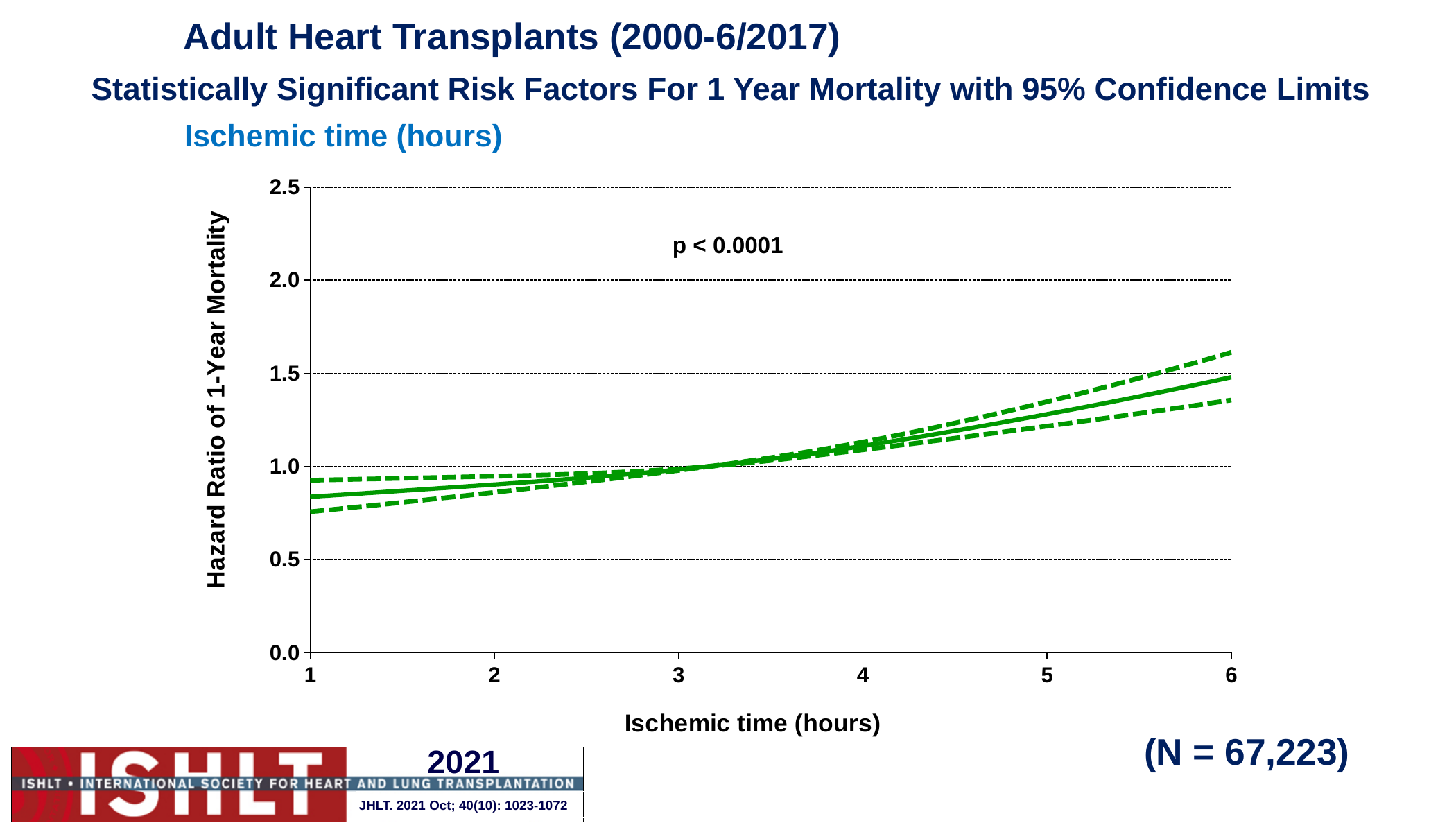
What p-value is printed on the chart? p < 0.0001 Is the hazard ratio (solid line) at an ischemic time of 1 hour greater or less than 1.0? less How many tick marks are labelled on the x axis (ischemic time)? 6 Does the hazard ratio of 1-year mortality rise or fall as ischemic time increases from 1 to 6 hours? rise How many lines are plotted on the chart? 3 Is the upper 95% confidence limit at an ischemic time of 6 hours greater or less than 1.5? greater Is the lower 95% confidence limit at an ischemic time of 1 hour greater or less than 0.5? greater What kind of chart is shown on the slide? line chart What sample size (N) is shown on the slide? N = 67,223